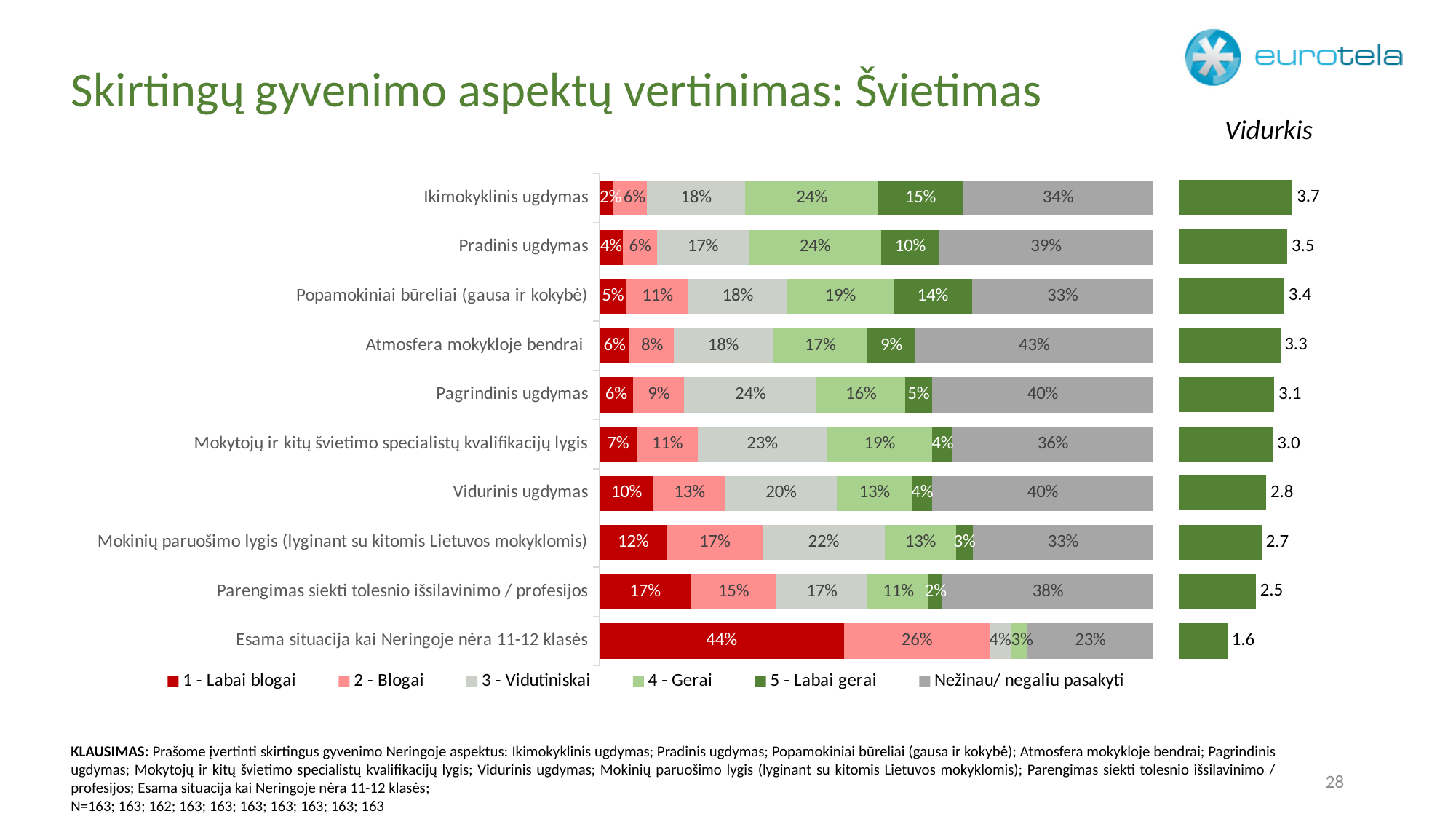
In the Vidurkis chart on the right, what is the average value for Popamokiniai būreliai (gausa ir kokybė)? 3.4 How many series does the legend of the stacked bar chart list? 6 In the Vidurkis chart on the right, which category has the highest average? Ikimokyklinis ugdymas In the stacked bar chart, what percentage answered "4 - Gerai" for Pagrindinis ugdymas? 16% In the stacked bar chart, which category has the highest "1 - Labai blogai" share? Esama situacija kai Neringoje nėra 11-12 klasės In the Vidurkis chart on the right, which category has the lowest average? Esama situacija kai Neringoje nėra 11-12 klasės In the stacked bar chart, what percentage of respondents answered "Nežinau/ negaliu pasakyti" for Atmosfera mokykloje bendrai? 43% In the stacked bar chart legend, what colour represents "5 - Labai gerai"? Dark green In the Vidurkis chart on the right, what is the difference between the averages for Ikimokyklinis ugdymas and Pradinis ugdymas? 0.2 In the stacked bar chart, which has the larger "1 - Labai blogai" share: Vidurinis ugdymas or Mokinių paruošimo lygis (lyginant su kitomis Lietuvos mokyklomis)? Mokinių paruošimo lygis (lyginant su kitomis Lietuvos mokyklomis) How many categories (rows) are shown in the stacked bar chart? 10 What type of chart is the main chart on the left of the slide? Stacked bar chart